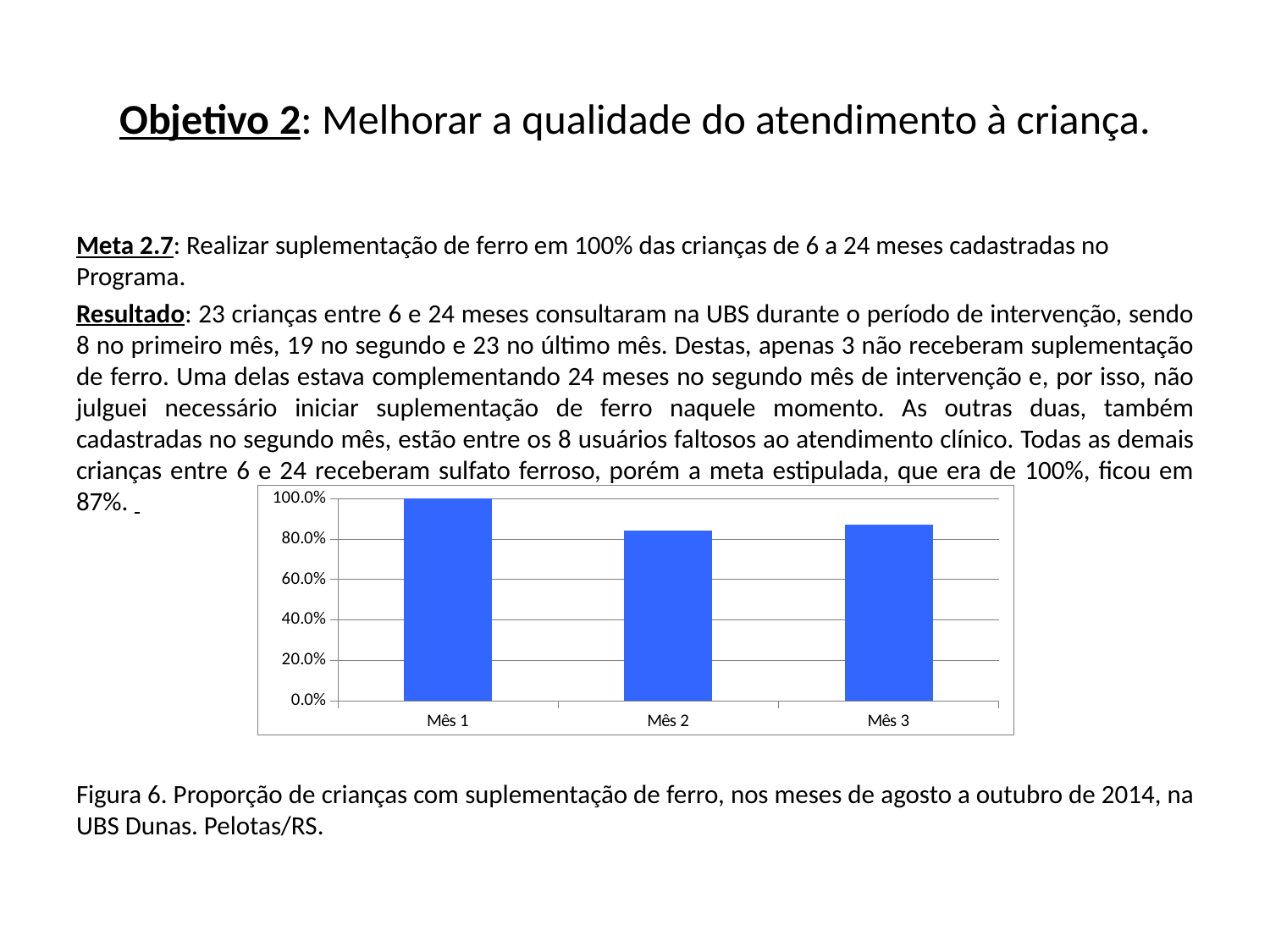
Is the value for Mês 3 greater or less than 100.0%? less Is the value for Mês 2 greater or less than 80.0%? greater Is the value for Mês 2 greater or less than 100.0%? less What colour are the bars in the chart? blue What is the value for Mês 1 in the chart? 100.0% Which month has the highest value in the chart? Mês 1 How many months (categories) are plotted in the chart? 3 What type of chart is shown on the slide? bar chart Which is larger, the value for Mês 1 or the value for Mês 2? Mês 1 What is the highest tick value shown on the vertical axis of the chart? 100.0% Does the value fall or rise from Mês 1 to Mês 2? fall